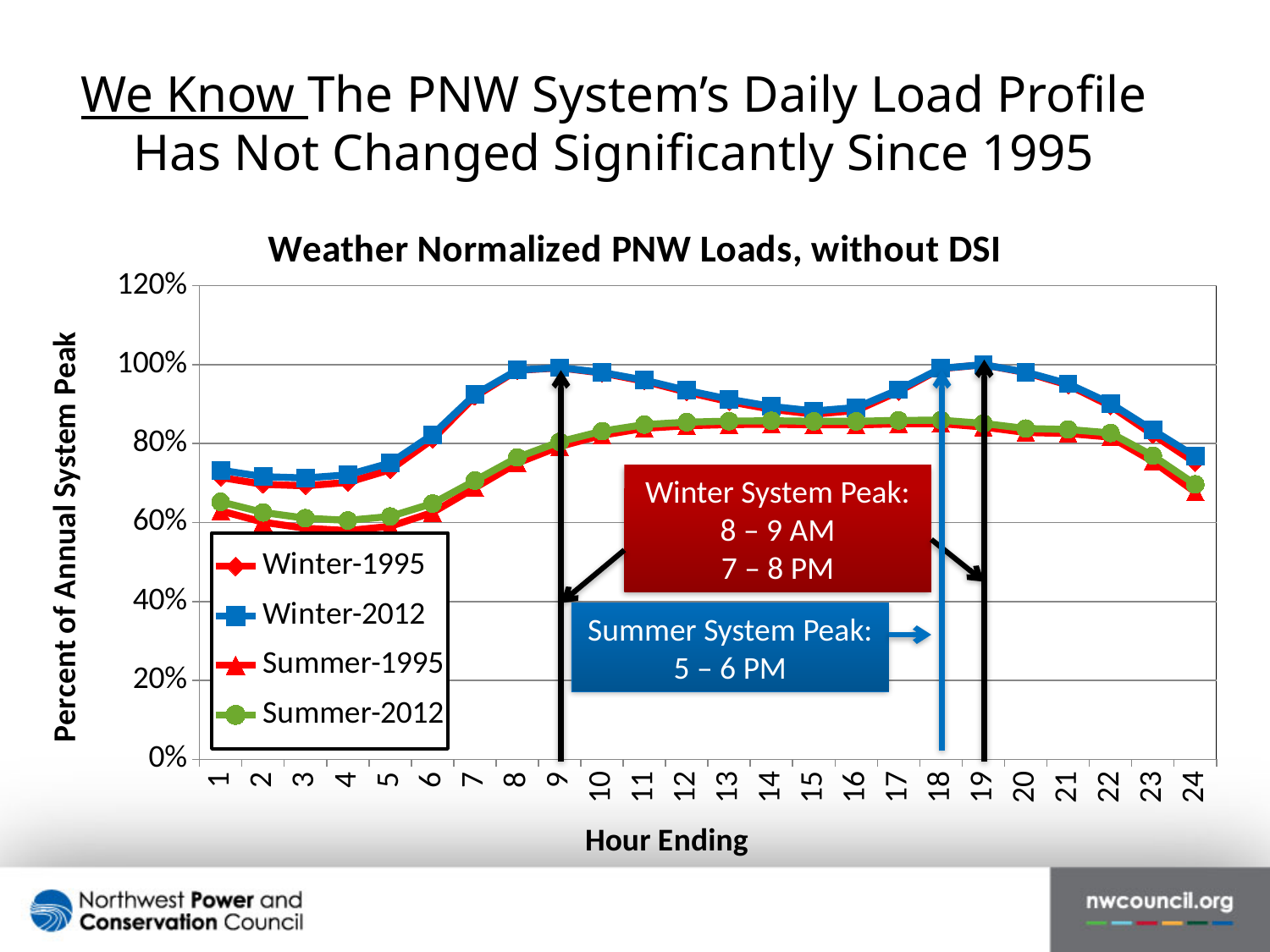
At hour ending 9, which series has the larger value, Winter-2012 or Summer-2012? Winter-2012 What is the title of the chart? Weather Normalized PNW Loads, without DSI What is the label of the chart's x axis? Hour Ending Is the value for Summer-2012 at hour ending 24 greater or less than 80%? less How many series does the chart legend list? 4 Is the value for Winter-2012 at hour ending 1 greater or less than 60%? greater What is the value for Winter-2012 at hour ending 19? 100% Do the Winter-2012 values rise or fall from hour ending 1 to hour ending 9? rise Is the value for Summer-2012 at hour ending 13 greater or less than 80%? greater How many hours are plotted along the x axis of the chart? 24 What kind of chart is shown on the slide? line chart